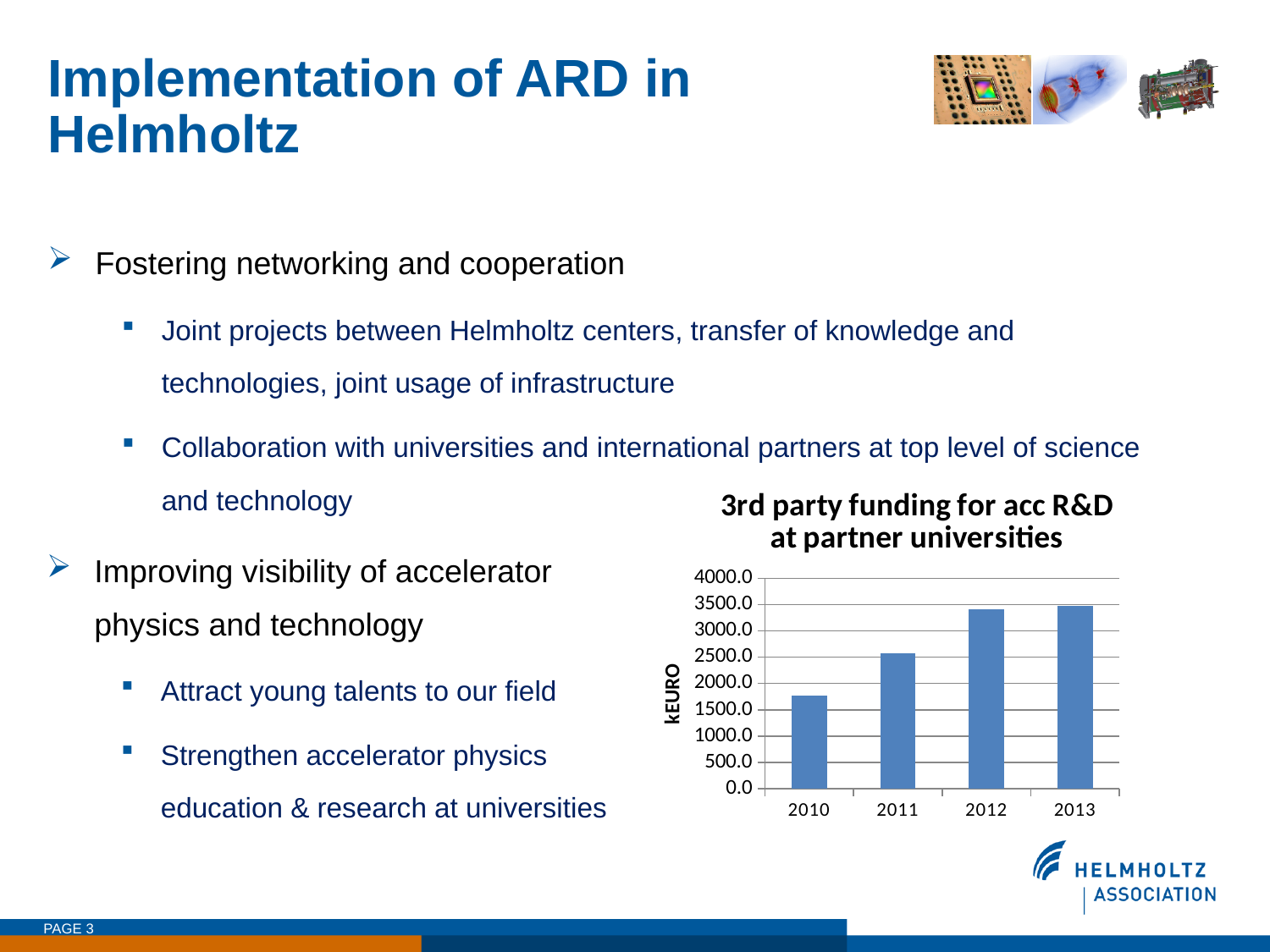
What kind of chart is shown on the slide? bar chart Is the value for 2012 greater or less than 3000? greater Which is larger, the value for 2010 or the value for 2012? 2012 Is the value for 2010 greater or less than 1500? greater What is the label on the vertical axis of the chart? kEURO Is the value for 2011 greater or less than 3000? less Do the values in the chart rise or fall from 2010 to 2013? rise How many years are shown on the x axis of the chart? 4 Which year has the lowest 3rd party funding in the chart? 2010 What is the title of the chart? 3rd party funding for acc R&D at partner universities